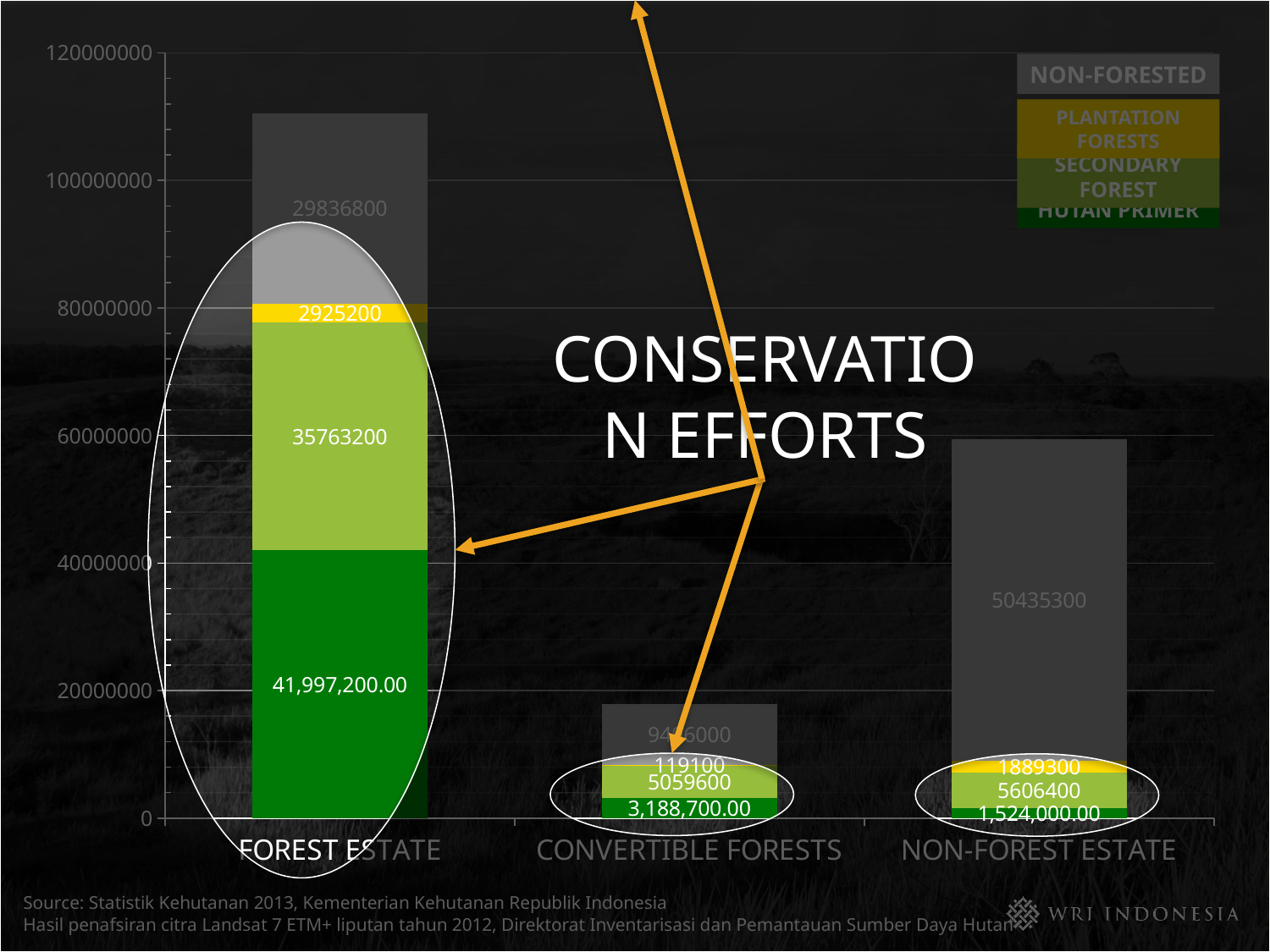
What kind of chart is shown on the slide? stacked bar chart What is the NON-FORESTED value for NON-FOREST ESTATE? 50435300 How many series does the chart's legend list? 4 What is the SECONDARY FOREST value for CONVERTIBLE FORESTS? 5059600 Which category has the lowest PLANTATION FORESTS value? CONVERTIBLE FORESTS Which is larger: the NON-FORESTED value for FOREST ESTATE or for NON-FOREST ESTATE? NON-FOREST ESTATE What is the total of the stacked bar for NON-FOREST ESTATE? 59455000 How many categories are shown on the x axis of the chart? 3 Which category has the highest HUTAN PRIMER value? FOREST ESTATE What is the HUTAN PRIMER value for FOREST ESTATE? 41,997,200.00 What is the difference between the SECONDARY FOREST values for FOREST ESTATE and NON-FOREST ESTATE? 30156800 What is the PLANTATION FORESTS value for NON-FOREST ESTATE? 1889300